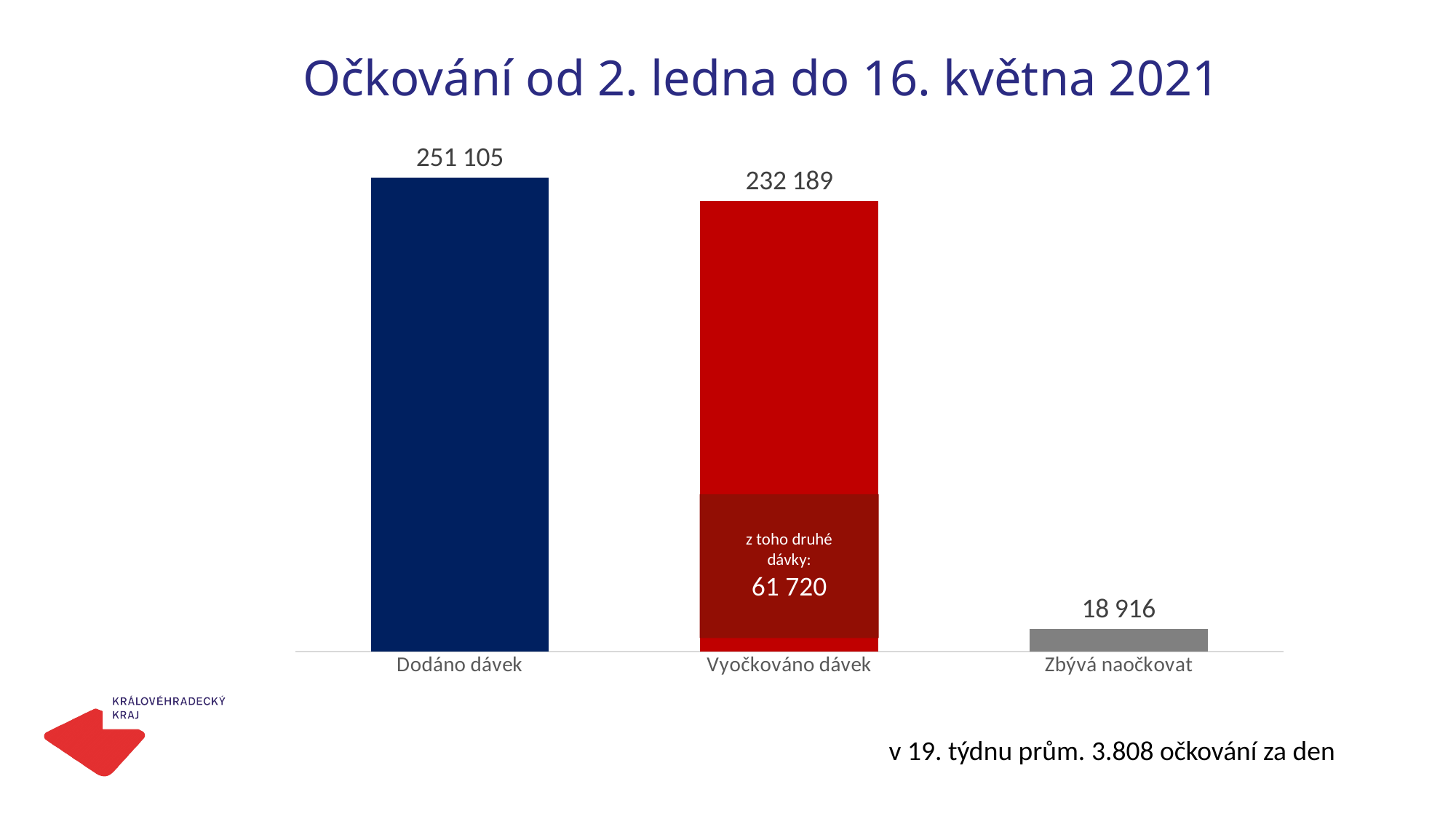
What is the title of the chart? Očkování od 2. ledna do 16. května 2021 How many categories are shown on the x axis? 3 What is the difference between Dodáno dávek and Vyočkováno dávek? 18 916 How many second doses (druhé dávky) are shown inside the Vyočkováno dávek bar? 61 720 What is the value for Zbývá naočkovat? 18 916 What is the value for Dodáno dávek? 251 105 Which category has the highest value? Dodáno dávek Which is larger, Dodáno dávek or Vyočkováno dávek? Dodáno dávek What is the difference between Vyočkováno dávek and Zbývá naočkovat? 213 273 What is the value for Vyočkováno dávek? 232 189 Which category has the lowest value? Zbývá naočkovat What kind of chart is shown on the slide? Bar chart